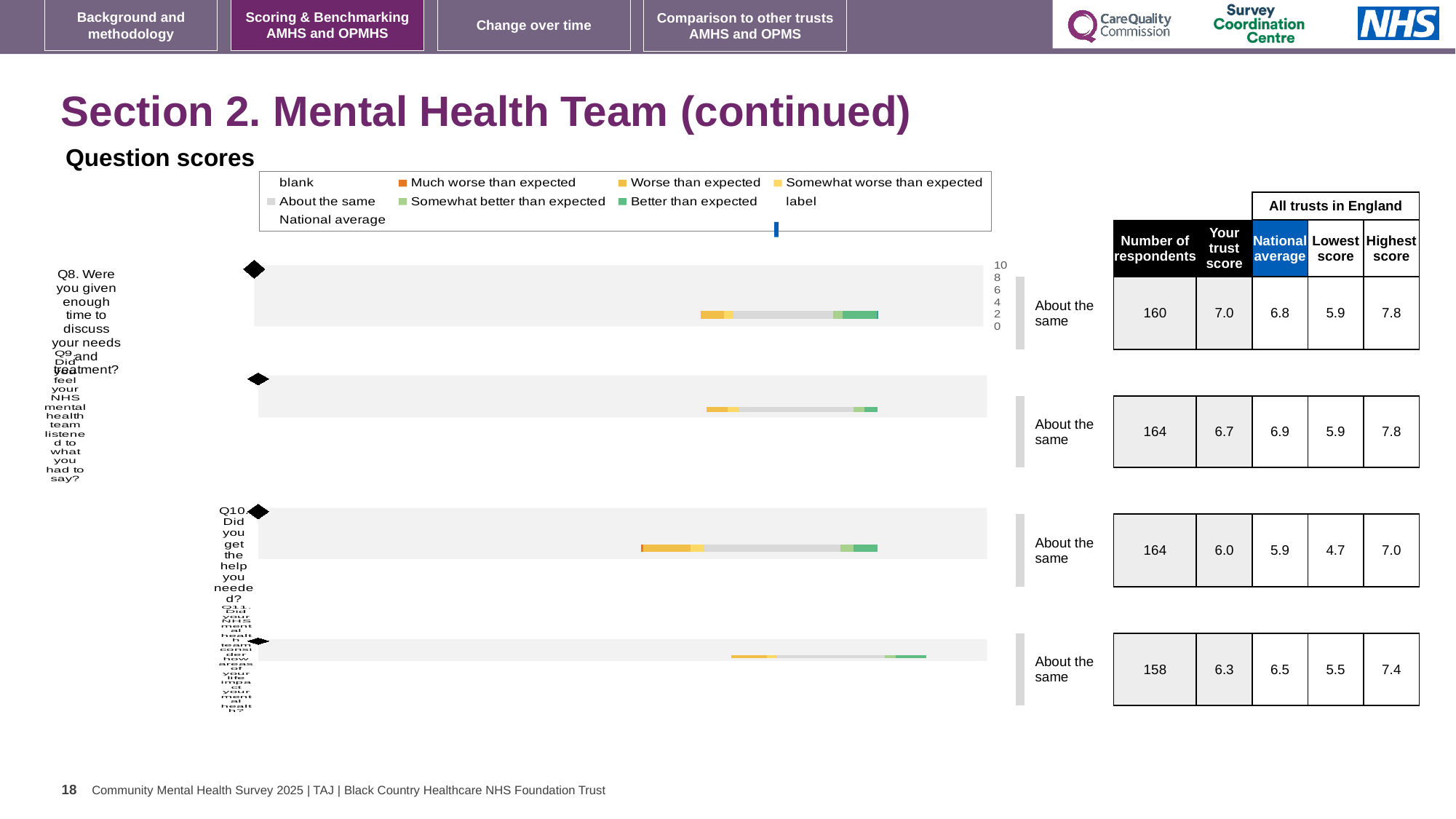
What is the heading above the charts on this slide? Question scores What kind of chart is used to show the question scores for Q8 to Q11? bar chart For the Q9 chart, what is the 'Your trust score' value? 6.7 How many question charts (Q8 to Q11) are shown on the slide? 4 What category label is shown next to the Q8 chart? About the same Which question (Q8 to Q11) has the lowest number of respondents? Q11 (158) For the Q10 chart, what is the national average score? 5.9 Which question (Q8 to Q11) has the lowest 'Your trust score'? Q10 (6.0) For the Q11 chart, what is the highest score among all trusts in England? 7.4 For the Q8 chart, what is the number of respondents shown in the table? 160 For the Q10 chart, what is the difference between the highest score (7.0) and the lowest score (4.7)? 2.3 For the Q8 chart, which is larger: the trust score or the national average? the trust score (7.0)